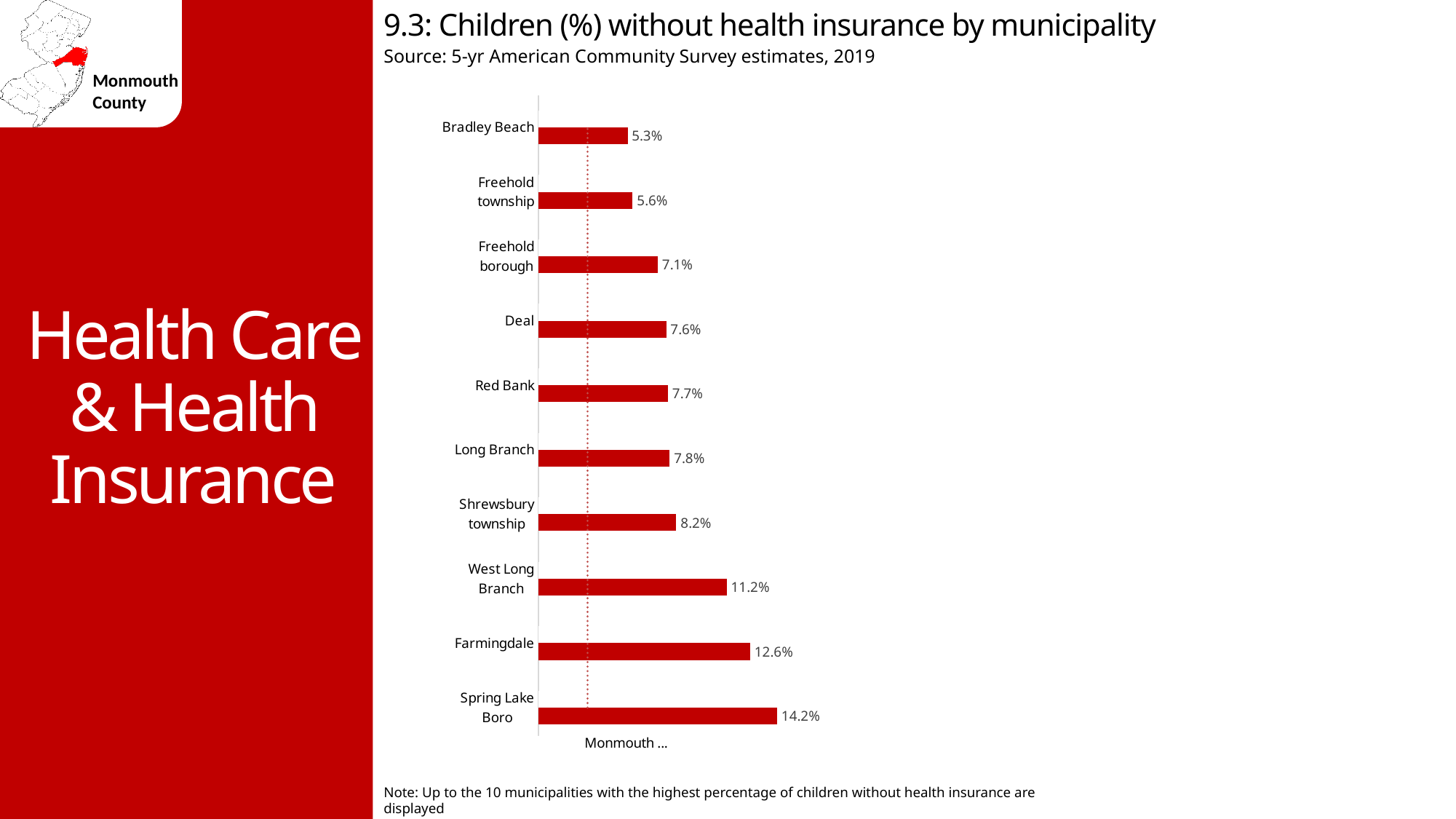
What is the difference between the values for Farmingdale and West Long Branch? 1.4% How many municipalities are shown in the chart? 10 Which has a higher percentage of children without health insurance, Shrewsbury township or Deal? Shrewsbury township Which has a higher value, Freehold borough or Farmingdale? Farmingdale What percentage is shown for Freehold township? 5.6% What kind of chart is used on this slide? Bar chart What is the title of the chart? 9.3: Children (%) without health insurance by municipality What is the difference between the values for Spring Lake Boro and Bradley Beach? 8.9% Which municipality has the lowest percentage of children without health insurance? Bradley Beach Which municipality has the highest percentage of children without health insurance? Spring Lake Boro What percentage of children in Spring Lake Boro are without health insurance? 14.2% What is the value shown for Red Bank? 7.7%